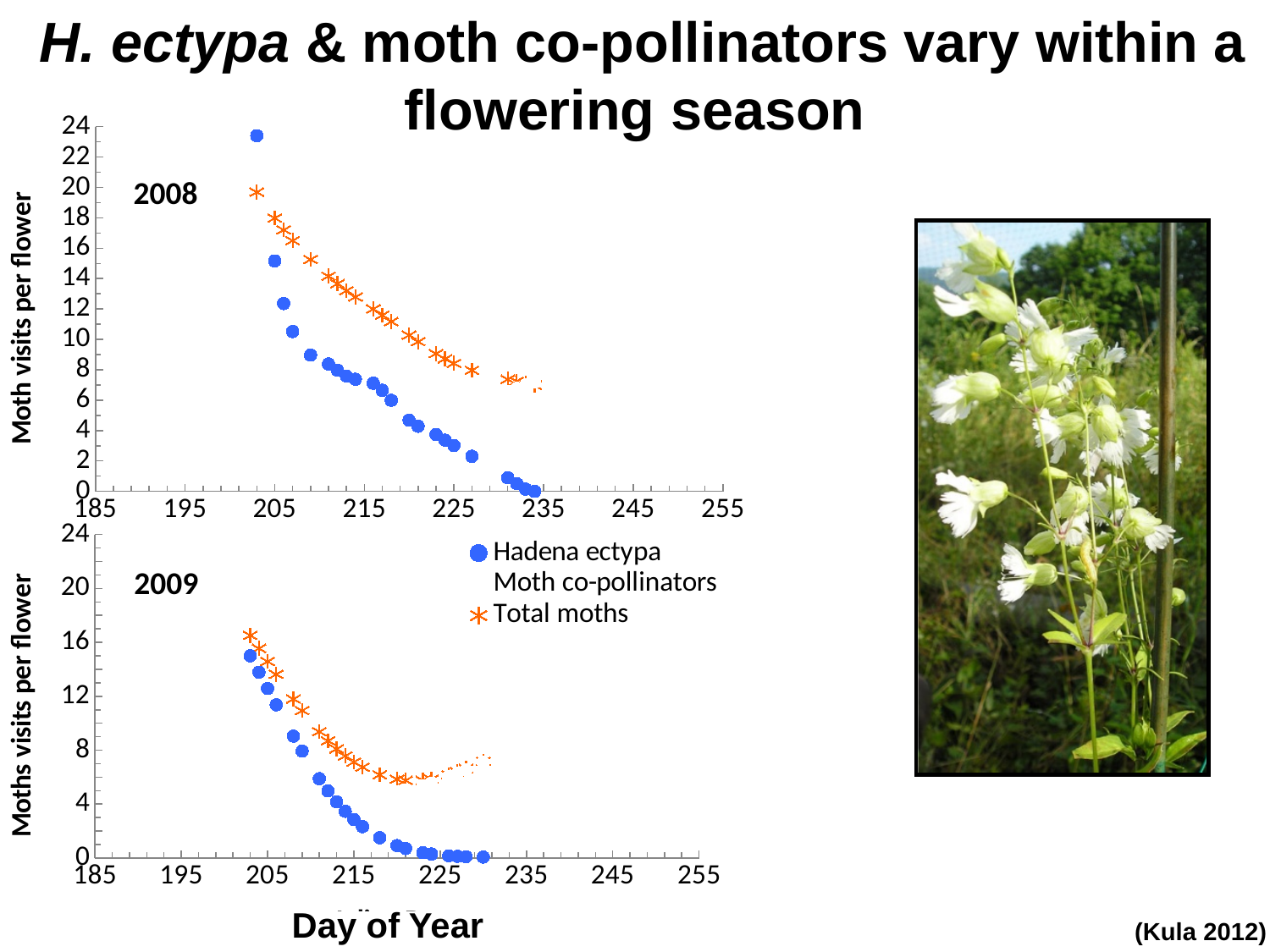
In the 2009 chart, at around day 215, which series has the larger value, Hadena ectypa or Total moths? Total moths What kind of chart is the top chart labelled 2008? scatter chart How many charts are plotted on the slide? 2 In the 2009 chart, is the first Hadena ectypa value (around day 203) greater or less than 12? greater In the 2009 chart, do the Total moths values rise or fall from day 205 to day 220? fall In the 2008 chart, at around day 210, which series has the larger value, Hadena ectypa or Total moths? Total moths In the 2008 chart, do the Hadena ectypa values rise or fall as the day of year increases? fall Which marker symbol represents Total moths in the legend? orange asterisk In the 2009 chart, is the Hadena ectypa value at around day 230 greater or less than 4? less In the 2008 chart, is the Total moths value at around day 225 greater or less than 12? less What is the label of the x axis shared by the two charts? Day of Year